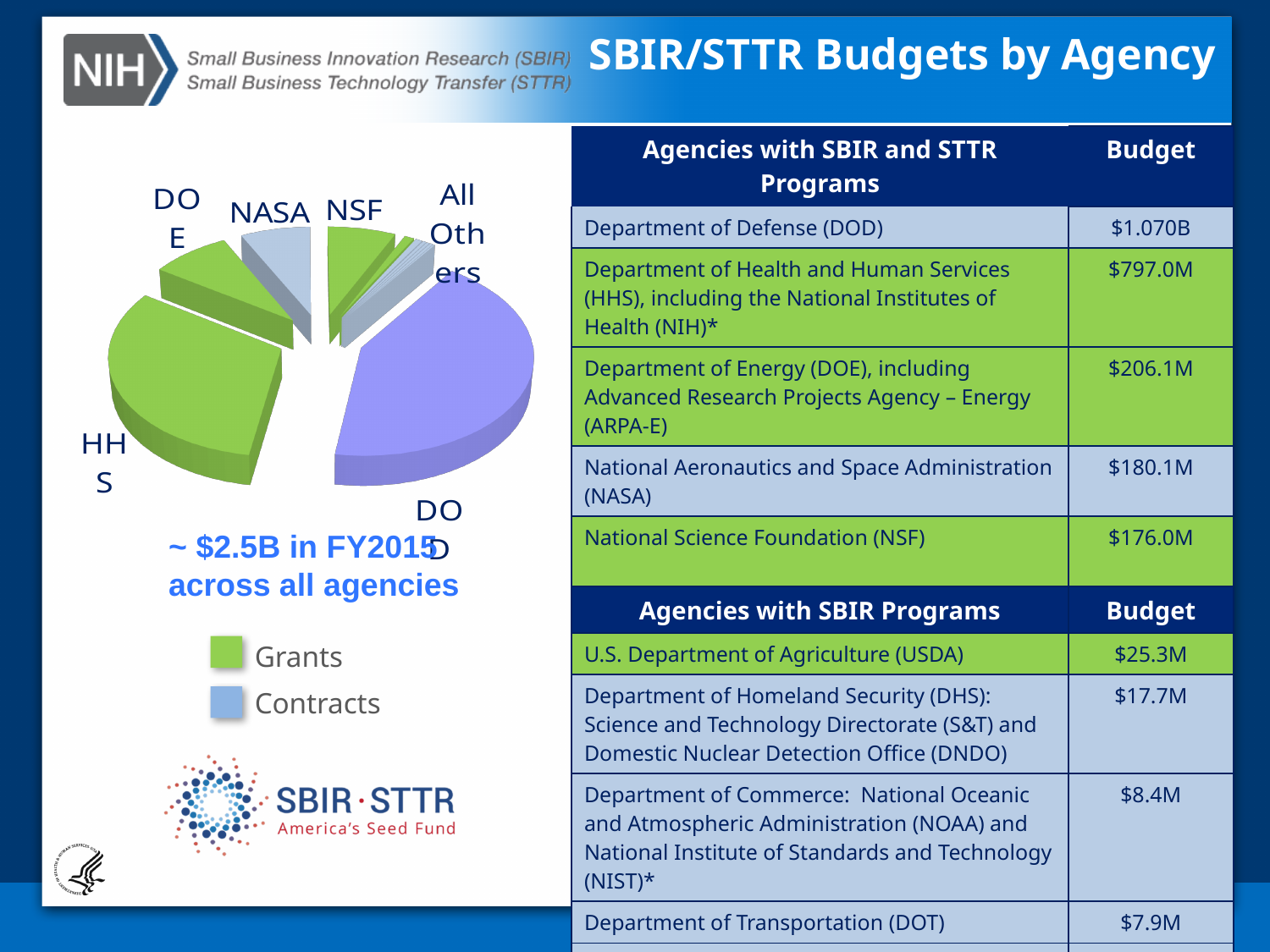
In the pie chart, which slice is larger, DOD or HHS? DOD What colour represents Grants in the pie chart? Green In the pie chart, which slice is larger, DOE or All Others? DOE In the pie chart, which slice is larger, HHS or NASA? HHS What kind of chart is shown on the left of the slide? Pie chart What two entries does the legend below the pie chart list? Grants and Contracts Which agency has the largest slice in the pie chart? DOD